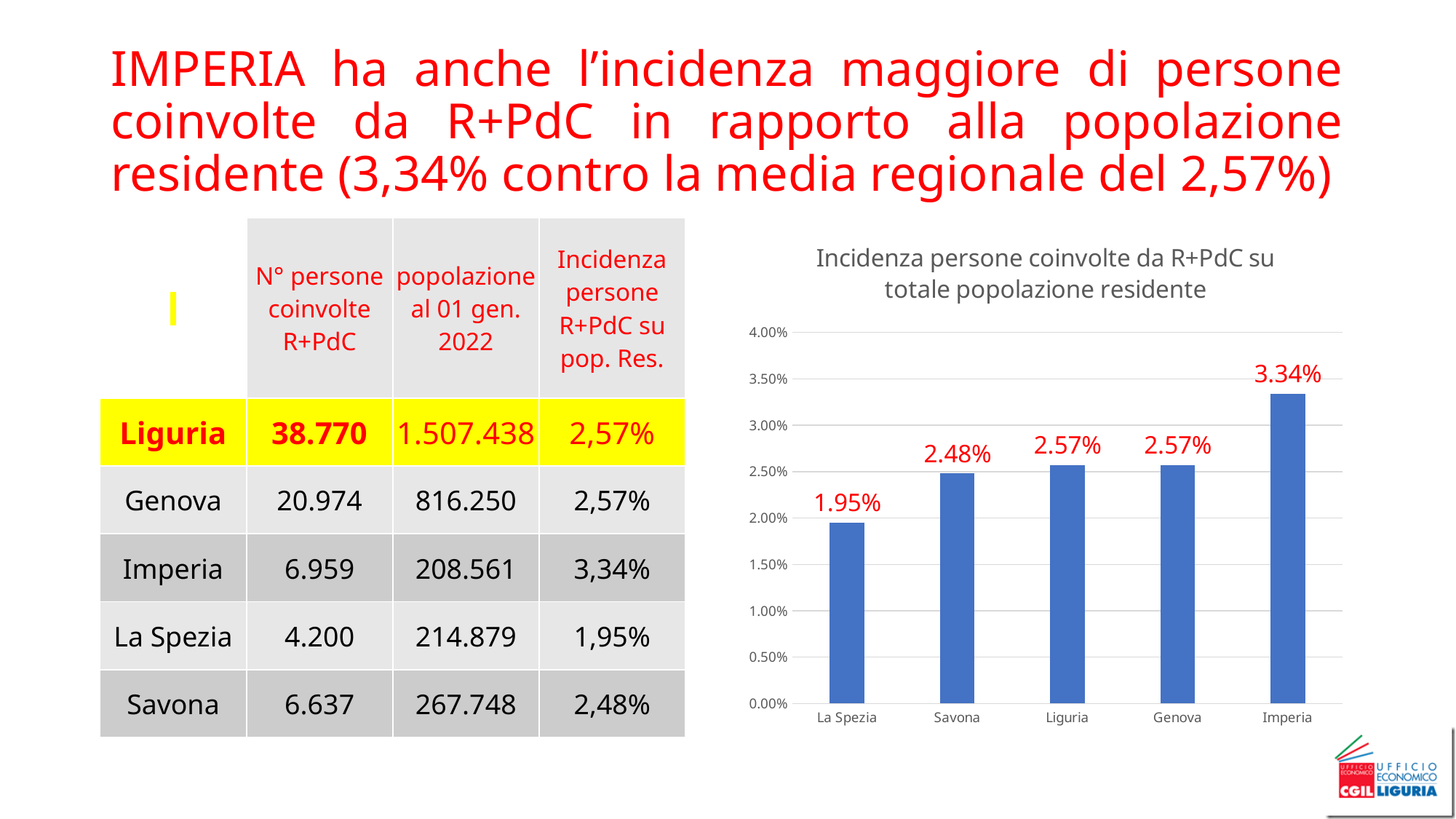
What is the value for La Spezia in the chart? 1.95% How many categories are shown on the x axis of the chart? 5 What is the value for Genova in the chart? 2.57% Which is larger, the value for Savona or the value for Imperia? Imperia Which category has the lowest value in the chart? La Spezia Which category has the highest value in the chart? Imperia Is the value for Liguria greater or less than 3.00%? less What is the difference between the values for Imperia and La Spezia? 1.39% What is the value for Savona in the chart? 2.48% What is the title of the chart? Incidenza persone coinvolte da R+PdC su totale popolazione residente What kind of chart is shown on the slide? bar chart What is the value for Imperia in the chart? 3.34%